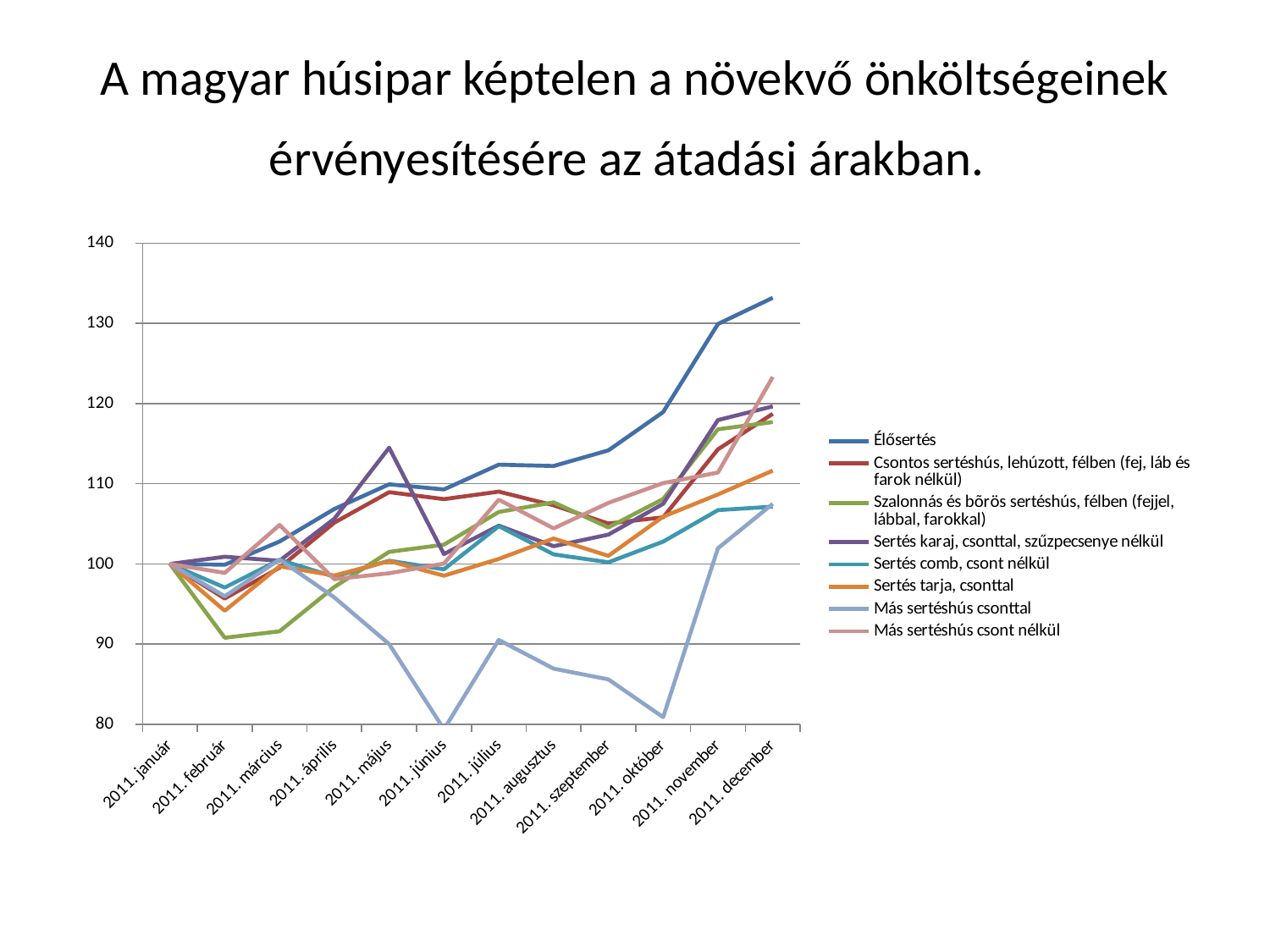
Is the value for Szalonnás és bőrös sertéshús, félben (fejjel, lábbal, farokkal) in 2011. február greater or less than 100? less In 2011. december, which is larger: Élősertés or Sertés tarja, csonttal? Élősertés What kind of chart is shown on the slide? line chart Is the value for Élősertés in 2011. december greater or less than 130? greater Which series has the lowest value in 2011. június? Más sertéshús csonttal Is the value for Más sertéshús csonttal in 2011. október greater or less than 90? less How many months are shown along the x axis? 12 What is the first category label on the x axis? 2011. január Which series has the highest value in 2011. december? Élősertés How many series does the legend list? 8 Does the Élősertés line rise or fall from 2011. január to 2011. december? rises